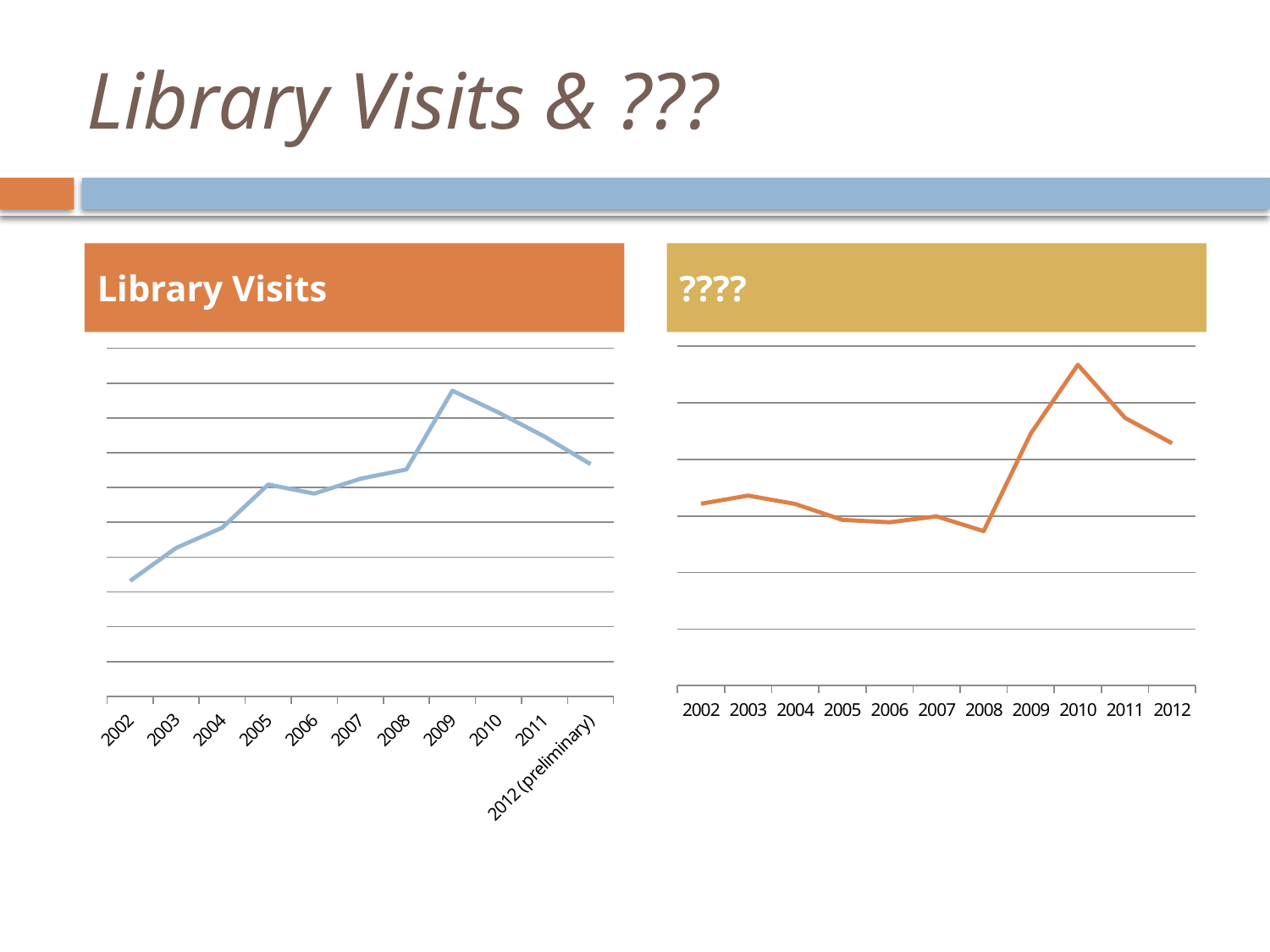
In the chart titled ????, which year has the highest value? 2010 In the chart titled ????, which is larger, the value for 2010 or the value for 2008? 2010 What kind of chart is the chart titled ???? on the right? line chart How many years are shown on the x axis of the chart titled ????? 11 What is the label of the last category on the x axis of the Library Visits chart? 2012 (preliminary) In the Library Visits chart, is the value for 2009 larger or smaller than the value for 2002? larger In the Library Visits chart, which year has the highest value? 2009 In the Library Visits chart, which year has the lowest value? 2002 In the Library Visits chart, does the line rise or fall from 2009 to 2012 (preliminary)? fall What kind of chart is the Library Visits chart on the left? line chart In the chart titled ????, which year has the lowest value? 2008 How many data points are plotted in the Library Visits chart? 11